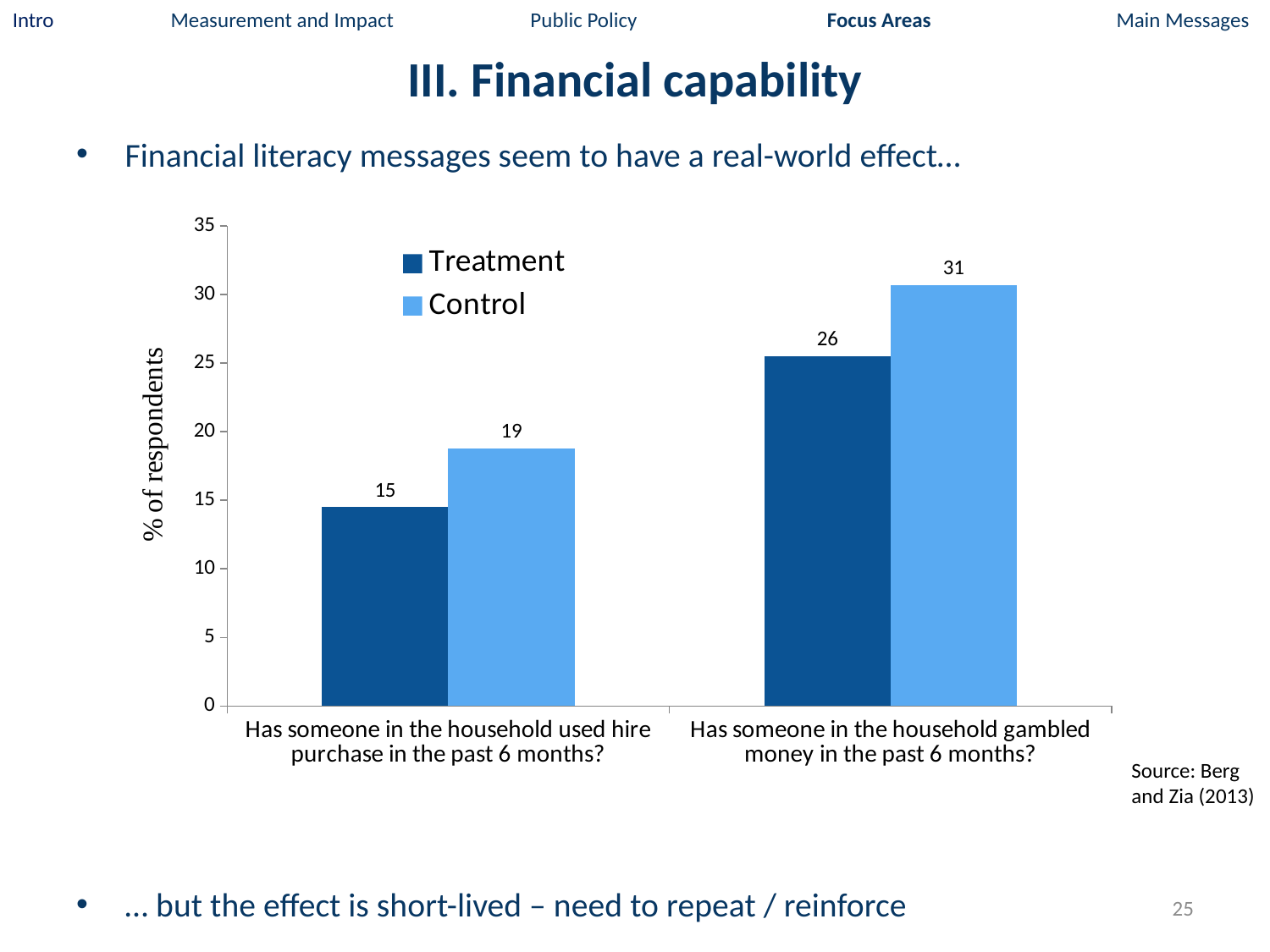
Which bar in the chart has the lowest value? Treatment, used hire purchase What is the Treatment value for "Has someone in the household gambled money in the past 6 months?"? 26 What is the label of the vertical axis? % of respondents Which bar in the chart has the highest value? Control, gambled money What is the difference between the Control and Treatment values for the gambling question? 5 What is the Control value for "Has someone in the household used hire purchase in the past 6 months?"? 19 What is the Control value for "Has someone in the household gambled money in the past 6 months?"? 31 How many series does the legend list? 2 Which series has the higher value for the gambling question, Treatment or Control? Control What is the difference between the Control and Treatment values for the hire purchase question? 4 What kind of chart is shown on the slide? Bar chart What is the Treatment value for "Has someone in the household used hire purchase in the past 6 months?"? 15